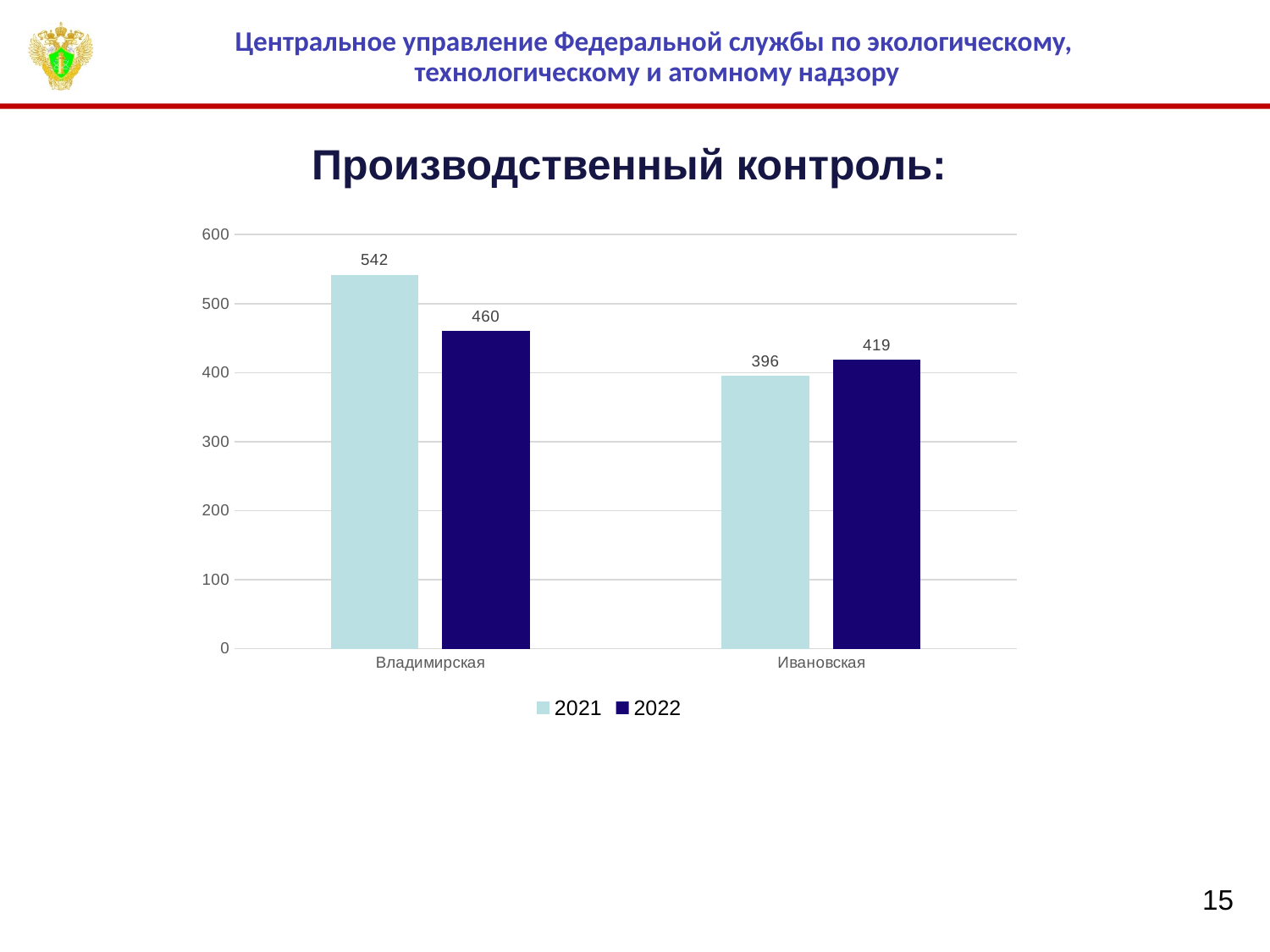
How many series does the legend list? 2 What kind of chart is shown on the slide? Bar chart Which category has the lowest value in the 2022 series? Ивановская What is the value for Владимирская in 2021? 542 What is the difference between the 2022 and 2021 values for Ивановская? 23 What is the difference between the 2021 and 2022 values for Владимирская? 82 What is the title of the chart? Производственный контроль: Which is larger: the 2021 value for Ивановская or the 2022 value for Владимирская? 2022 value for Владимирская How many categories are shown on the x axis? 2 What is the value for Владимирская in 2022? 460 What is the value for Ивановская in 2022? 419 Which category has the highest value in the 2021 series? Владимирская